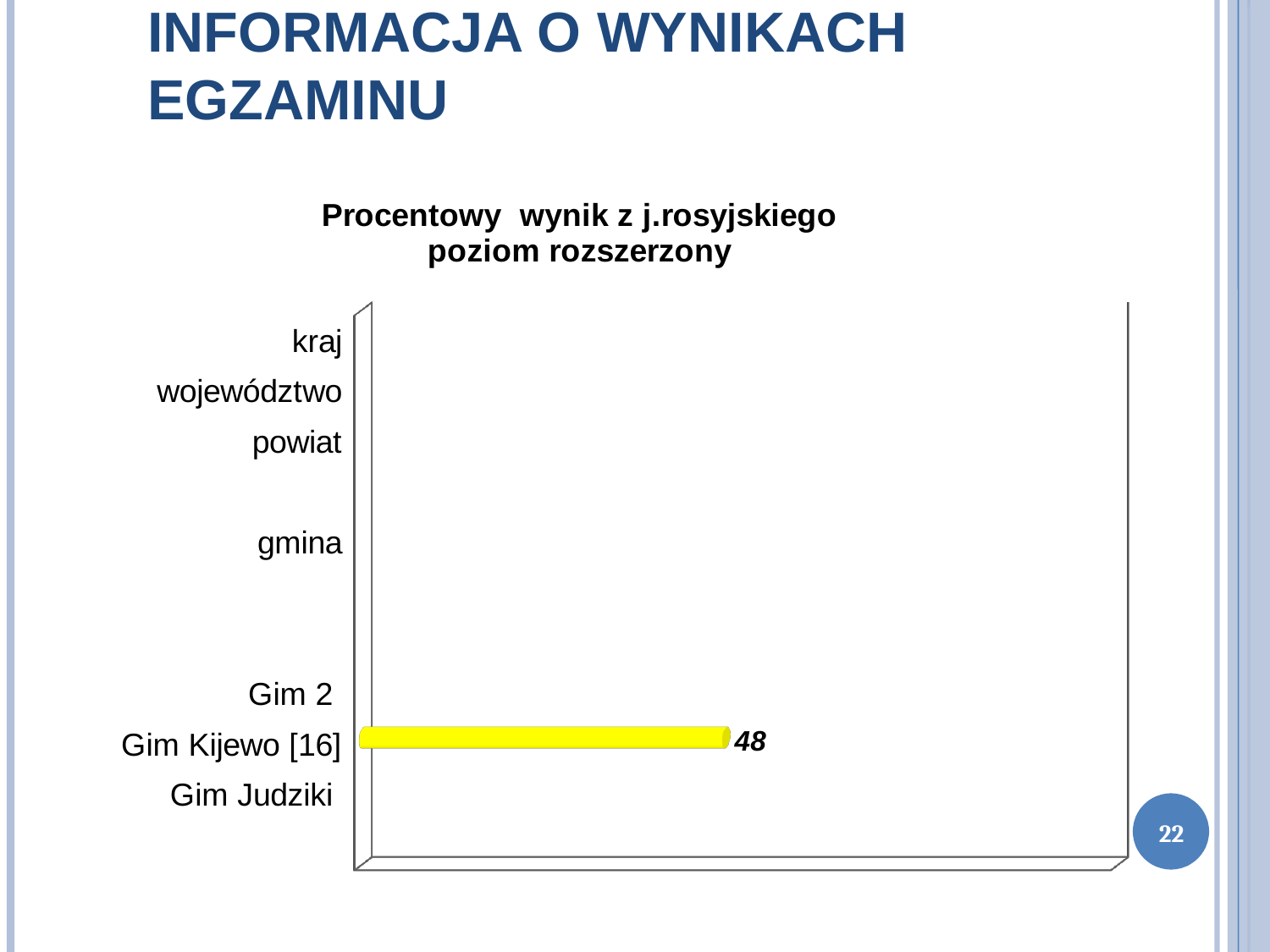
What is the title of the chart? Procentowy wynik z j.rosyjskiego poziom rozszerzony Which category is the only one with a plotted bar in the chart? Gim Kijewo [16] Which category appears at the top of the vertical axis? kraj What kind of chart is shown on the slide? bar chart Which category has the highest value in the chart? Gim Kijewo [16] How many categories are listed on the vertical axis of the chart? 7 What is the value shown for Gim Kijewo [16]? 48